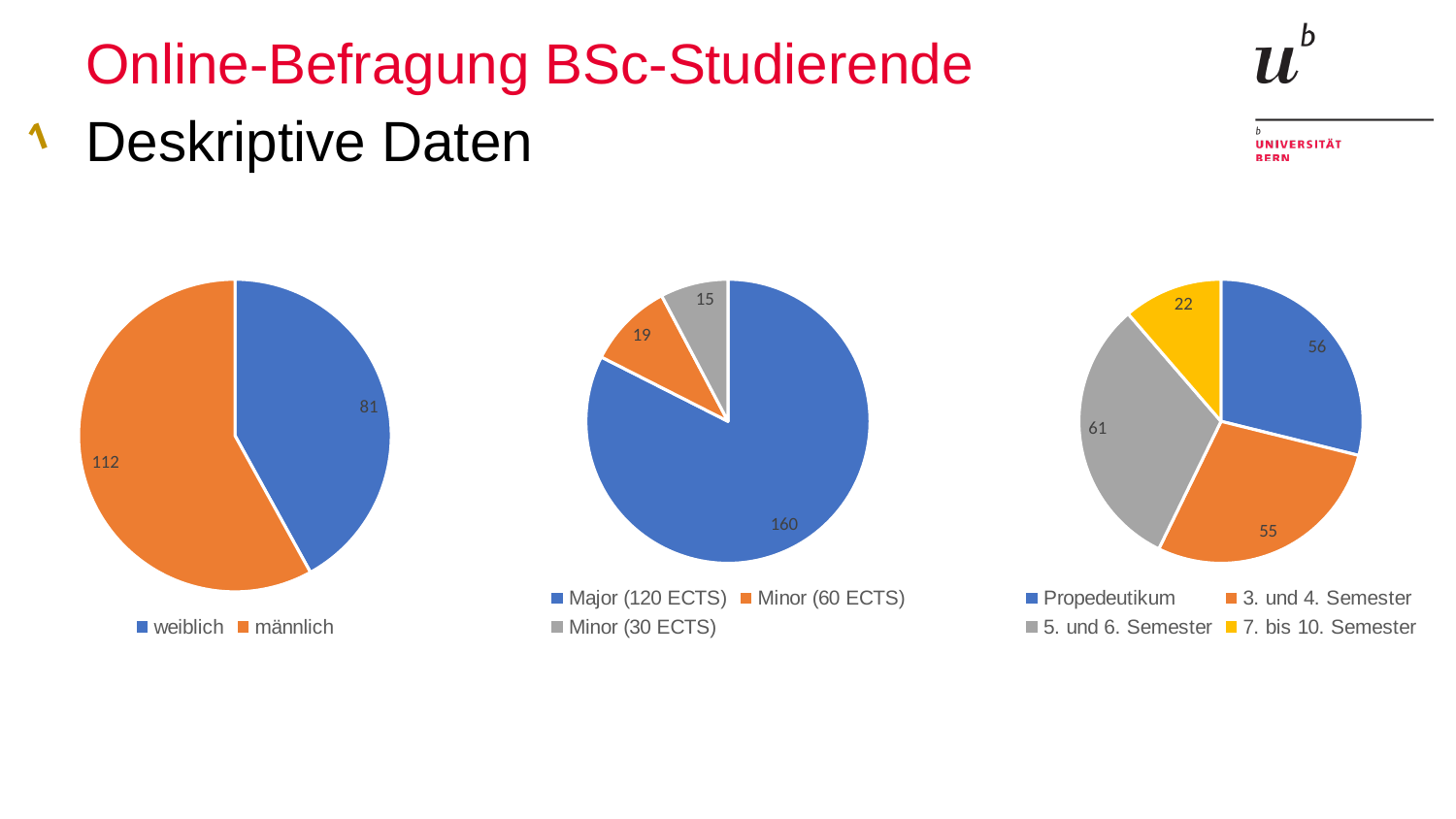
In the middle pie chart, what is the value for Major (120 ECTS)? 160 In the middle pie chart, what is the value for Minor (30 ECTS)? 15 In the left pie chart, what is the value for weiblich? 81 In the left pie chart, what is the value for männlich? 112 How many slices does the middle pie chart have? 3 In the right pie chart, which category has the largest slice? 5. und 6. Semester In the middle pie chart, which category has the smallest slice? Minor (30 ECTS) In the left pie chart, what is the difference between männlich and weiblich? 31 How many categories does the legend of the right pie chart list? 4 In the right pie chart, what is the value for 7. bis 10. Semester? 22 What type of chart is the left chart? Pie chart In the right pie chart, what is the value for 5. und 6. Semester? 61